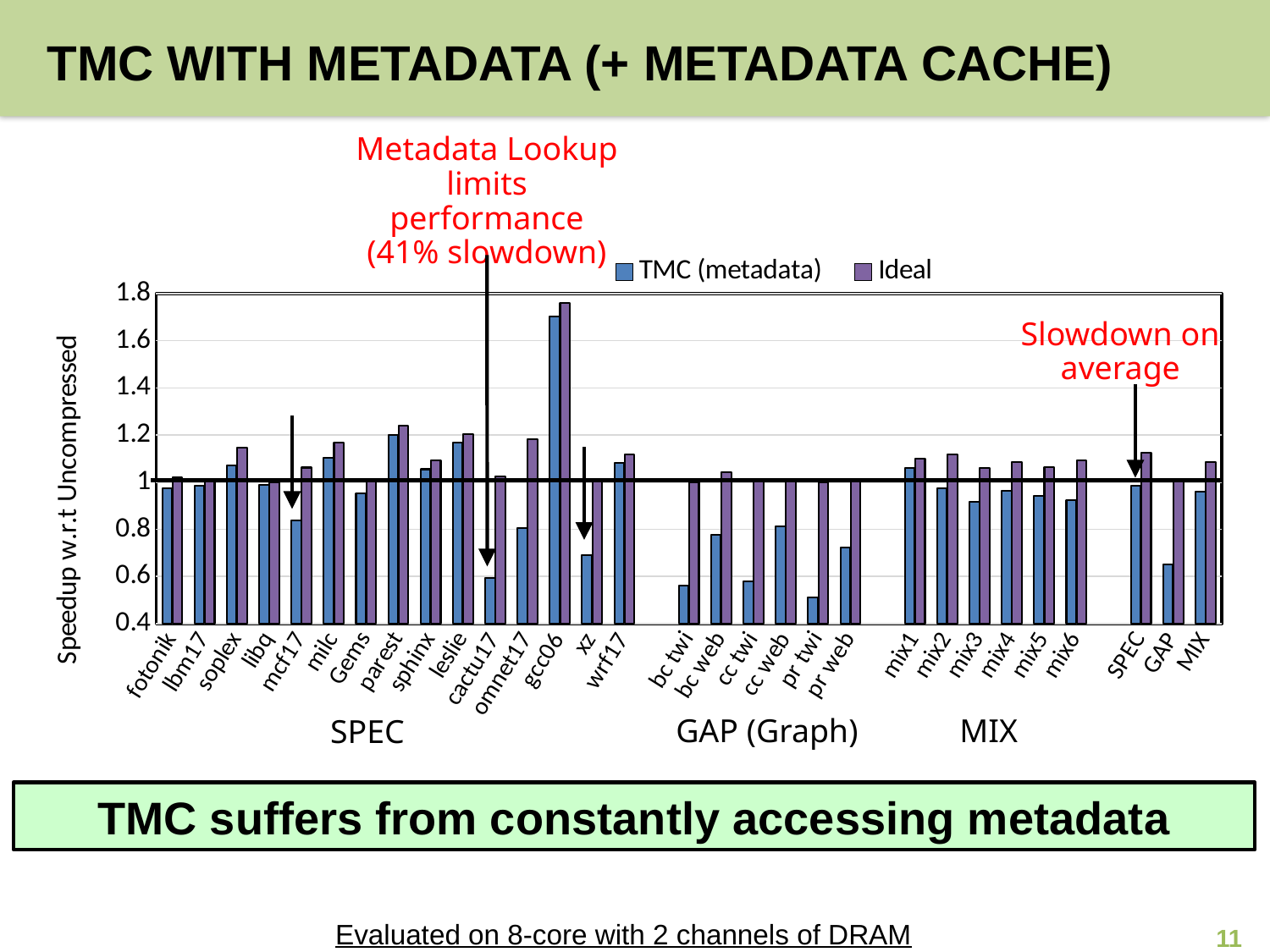
Is the TMC (metadata) value for gcc06 greater or less than 1.6? greater What kind of chart is shown on the slide? bar chart Which category has the highest Ideal value in the chart? gcc06 Which is larger: the TMC (metadata) value for gcc06 or the TMC (metadata) value for xz? gcc06 How many series does the chart legend list? 2 Is the TMC (metadata) value for GAP greater or less than 0.8? less What is the label on the y axis of the chart? Speedup w.r.t Uncompressed Is the TMC (metadata) value for parest greater or less than 1? greater Which category has the highest TMC (metadata) value in the chart? gcc06 For cactu17, which is larger: the TMC (metadata) value or the Ideal value? Ideal What are the two series named in the chart legend? TMC (metadata) and Ideal